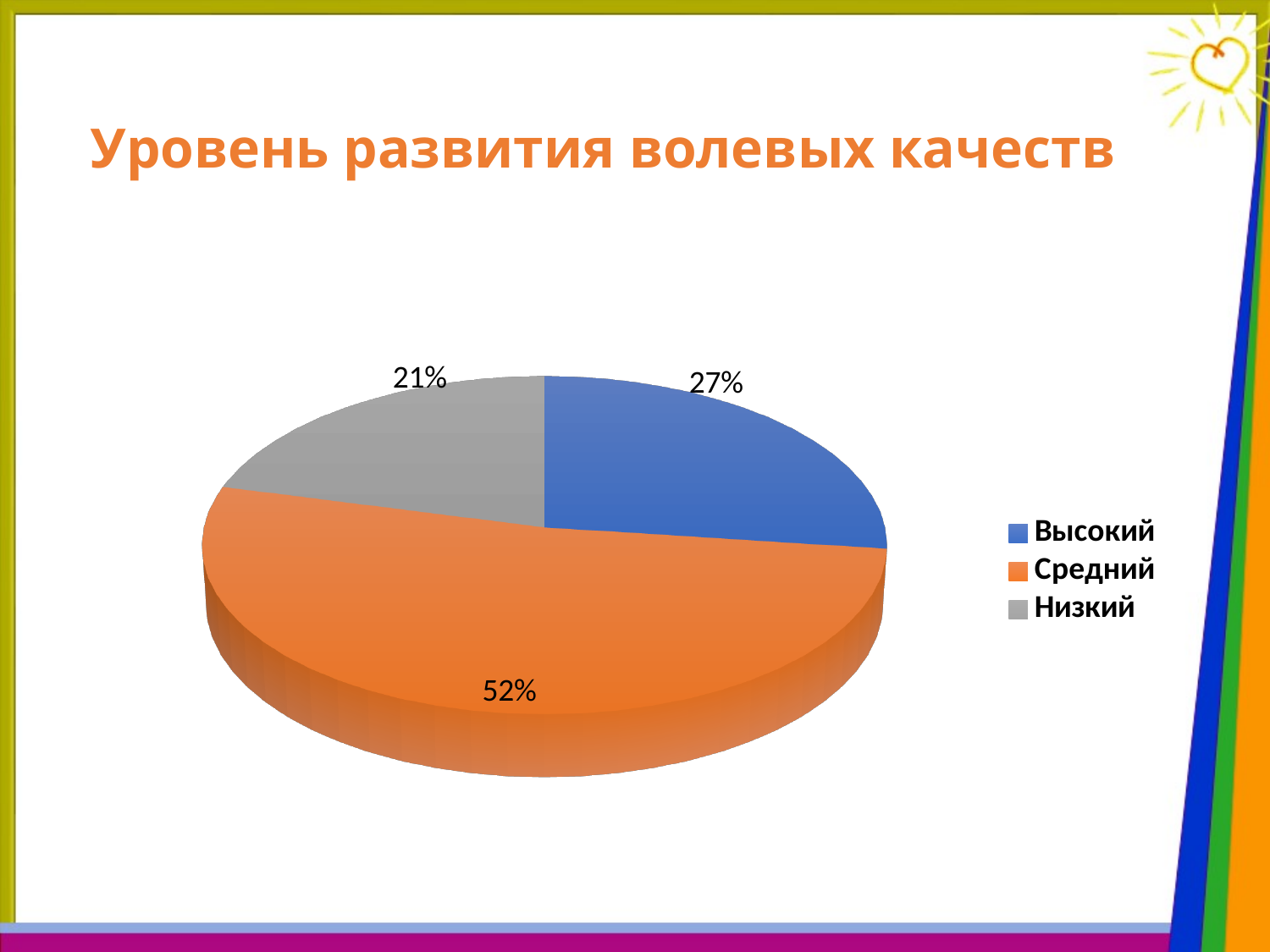
What percentage of the pie is labelled Низкий? 21% Which category has the largest share of the pie? Средний What colour is the slice for Средний? Orange Which is larger, the share for Высокий or the share for Низкий? Высокий Which category has the smallest share of the pie? Низкий What percentage of the pie is labelled Высокий? 27% What percentage of the pie is labelled Средний? 52% What is the title of the chart on the slide? Уровень развития волевых качеств What is the difference in percentage points between Высокий and Низкий? 6 What kind of chart is shown on the slide? Pie chart What is the difference in percentage points between Средний and Высокий? 25 How many slices does the pie chart have? 3